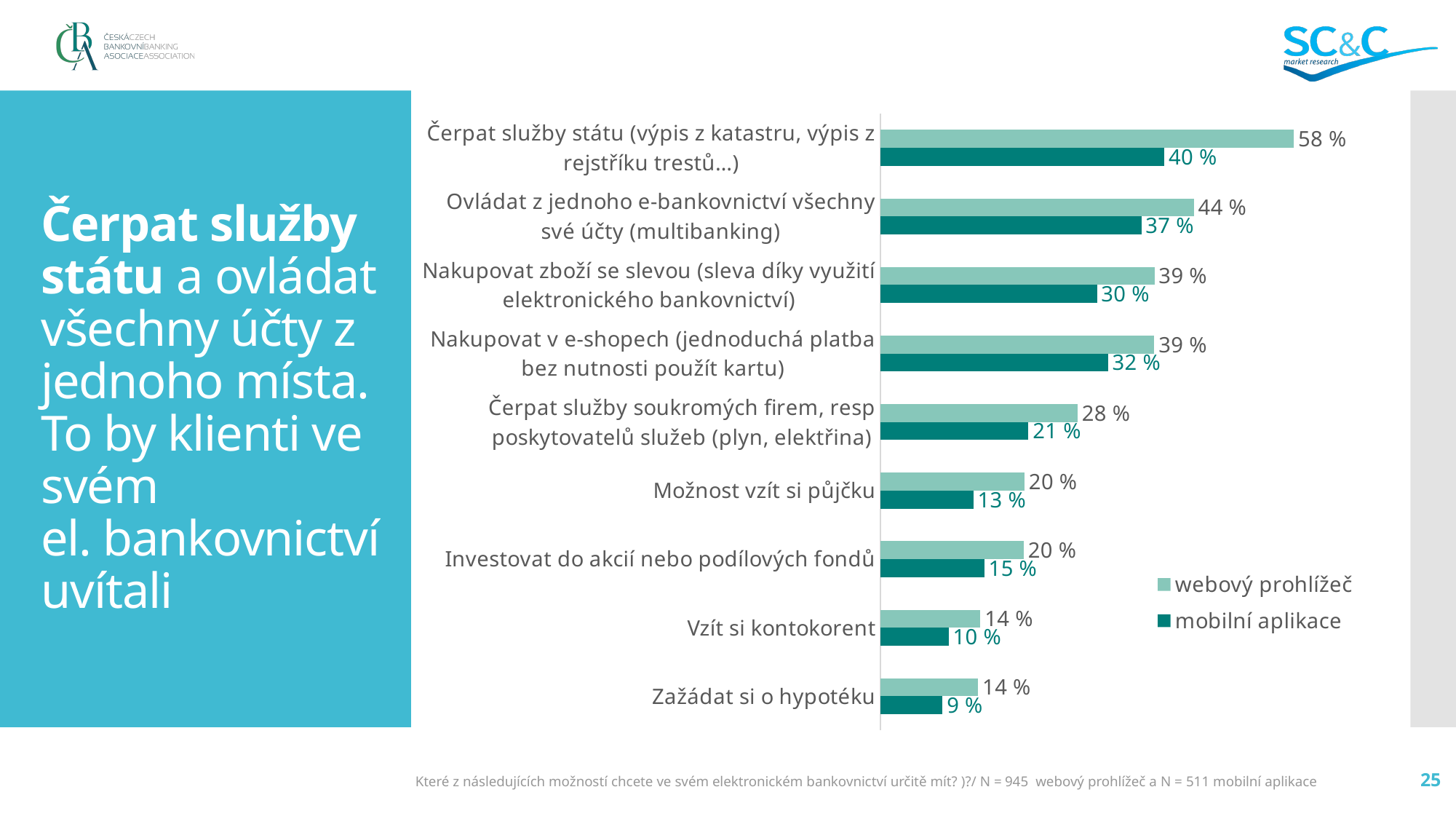
Which is larger for 'Možnost vzít si půjčku': the 'webový prohlížeč' value or the 'mobilní aplikace' value? webový prohlížeč What is the value for 'mobilní aplikace' for 'Zažádat si o hypotéku'? 9 % How many series does the legend list? 2 What is the value for 'mobilní aplikace' for 'Ovládat z jednoho e-bankovnictví všechny své účty (multibanking)'? 37 % Which series is shown in the darker teal colour in the legend? mobilní aplikace How many categories are shown in the chart? 9 What is the value for 'webový prohlížeč' for 'Čerpat služby státu (výpis z katastru, výpis z rejstříku trestů…)'? 58 % What is the difference between the 'webový prohlížeč' and 'mobilní aplikace' values for 'Čerpat služby státu (výpis z katastru, výpis z rejstříku trestů…)'? 18 % What is the difference between the 'mobilní aplikace' values for 'Nakupovat v e-shopech (jednoduchá platba bez nutnosti použít kartu)' and 'Vzít si kontokorent'? 22 % What kind of chart is shown on the slide? bar chart Which category has the highest value for 'webový prohlížeč'? Čerpat služby státu (výpis z katastru, výpis z rejstříku trestů…) Which category has the lowest value for 'mobilní aplikace'? Zažádat si o hypotéku